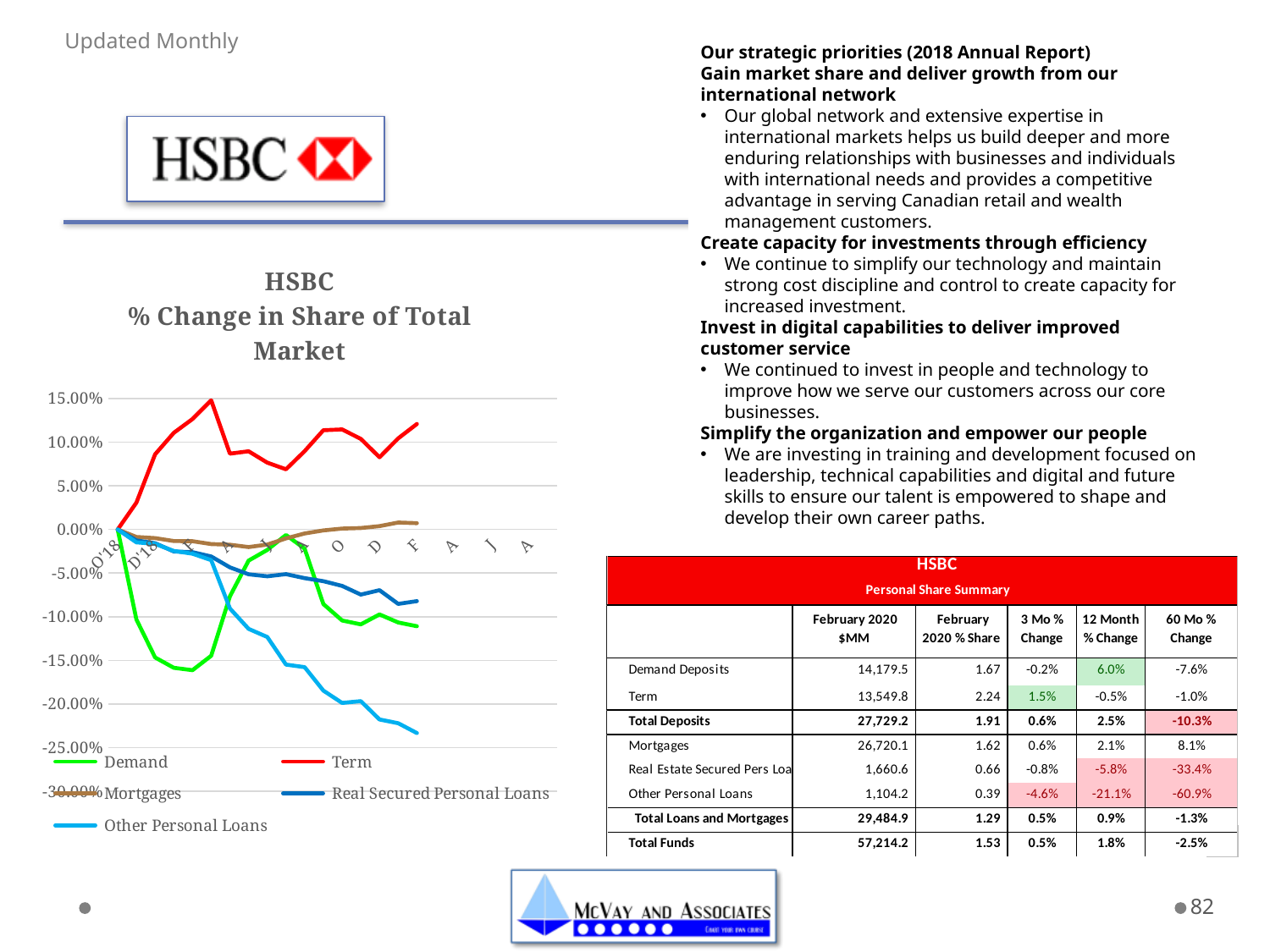
Is the final value of the Mortgages series greater or less than -5.00%? greater What kind of chart is shown on the slide? Line chart Which colour is used for the Term series in the chart? Red Which series has the highest value at the right end of the chart? Term Does the Other Personal Loans series generally rise or fall along the x axis? Fall Which series has the lowest value at the right end of the chart? Other Personal Loans Is the final value of the Real Secured Personal Loans series greater or less than -10.00%? greater What is the title of the chart? HSBC % Change in Share of Total Market At the right end of the chart, which is larger: the Term series or the Demand series? Term How many series does the legend of the chart list? 5 Is the final value of the Term series greater or less than 10.00%? greater